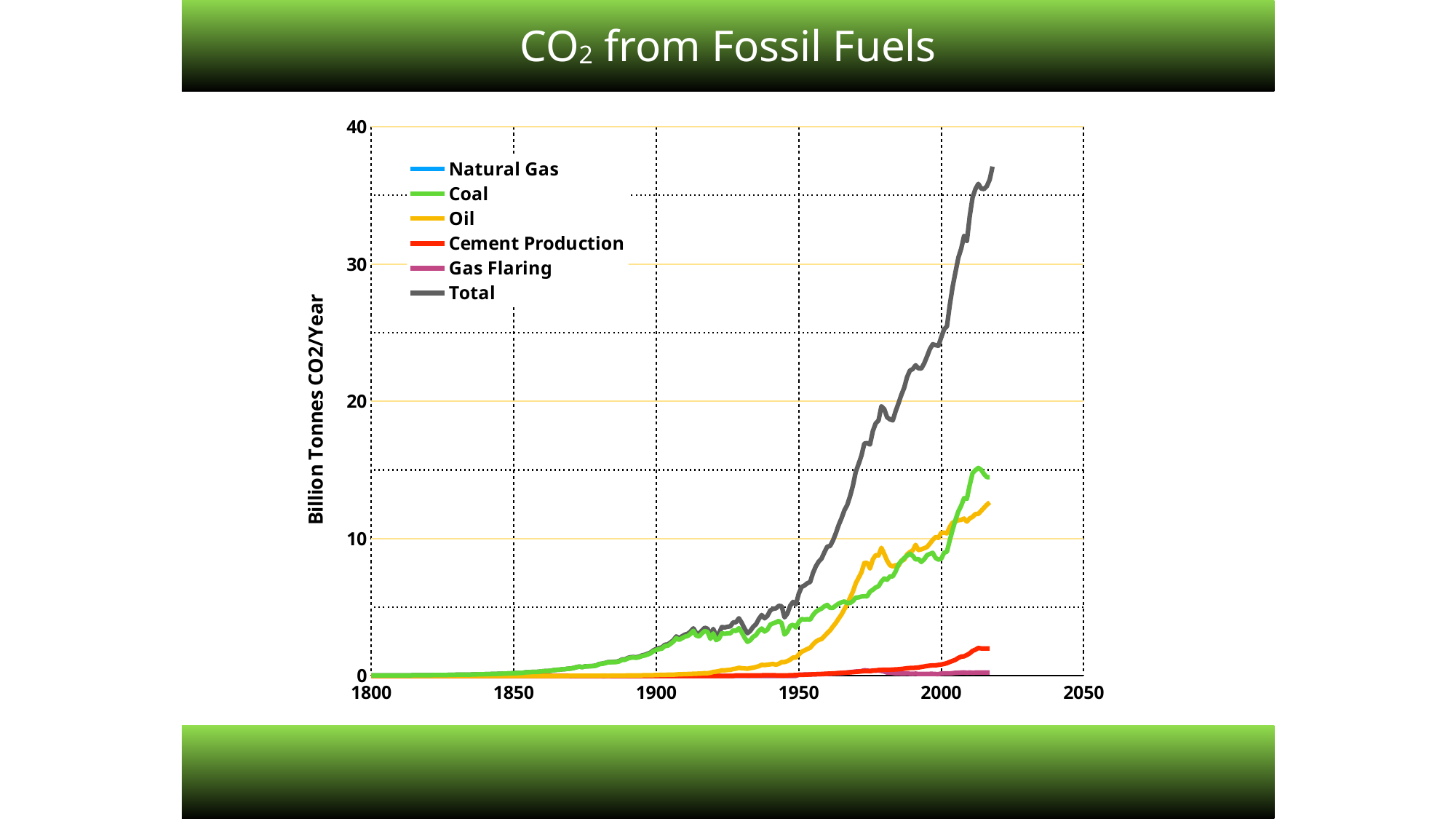
Which series is larger in 1950, Coal or Oil? Coal Is the value of the Cement Production series in 2010 greater or less than 10? less Is the highest value of the Coal series greater or less than 10? greater Which series reaches the highest value on the chart? Total Is the value of the Total series in 1950 greater or less than 10? less Which series is larger in 2010, Cement Production or Gas Flaring? Cement Production What is the label on the vertical axis? Billion Tonnes CO2/Year What is the title of the chart? CO2 from Fossil Fuels What kind of chart is shown on the slide? line chart How many series does the legend list? 6 Does the Total series generally rise or fall from 1800 to the end of the series? rise